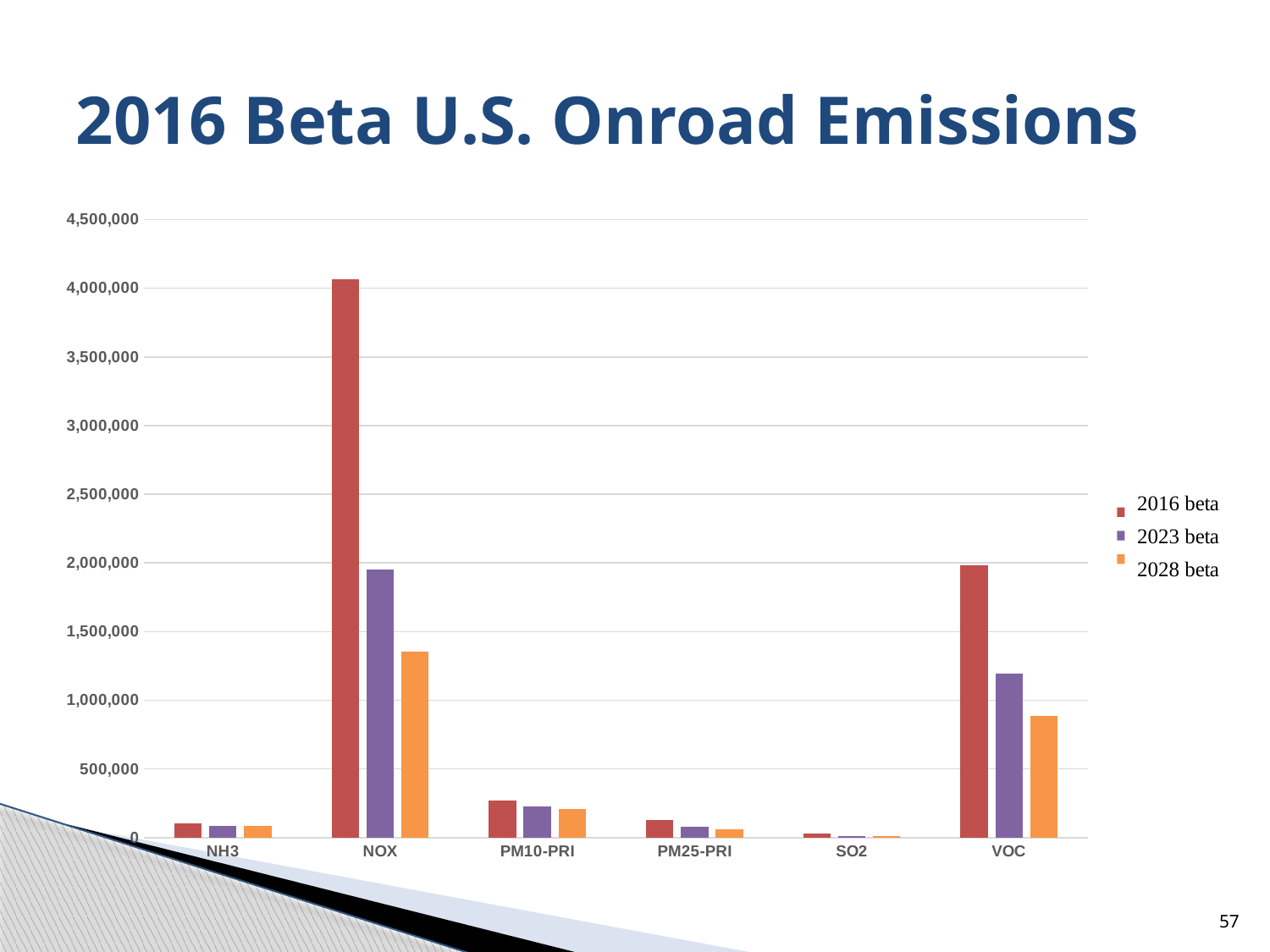
Is the 2023 beta value for NOX greater or less than 2,500,000? less Which pollutant has the highest 2016 beta emissions? NOX How many series does the legend list? 3 Which is larger: the 2016 beta value for VOC or the 2028 beta value for NOX? 2016 beta value for VOC How many pollutant categories are shown on the x axis? 6 For NOX, do the values rise or fall from 2016 beta to 2028 beta? fall Is the 2016 beta value for NOX greater or less than 3,500,000? greater What kind of chart is shown on the slide? bar chart Which pollutant has the lowest 2016 beta emissions? SO2 Is the 2028 beta value for VOC greater or less than 1,000,000? less